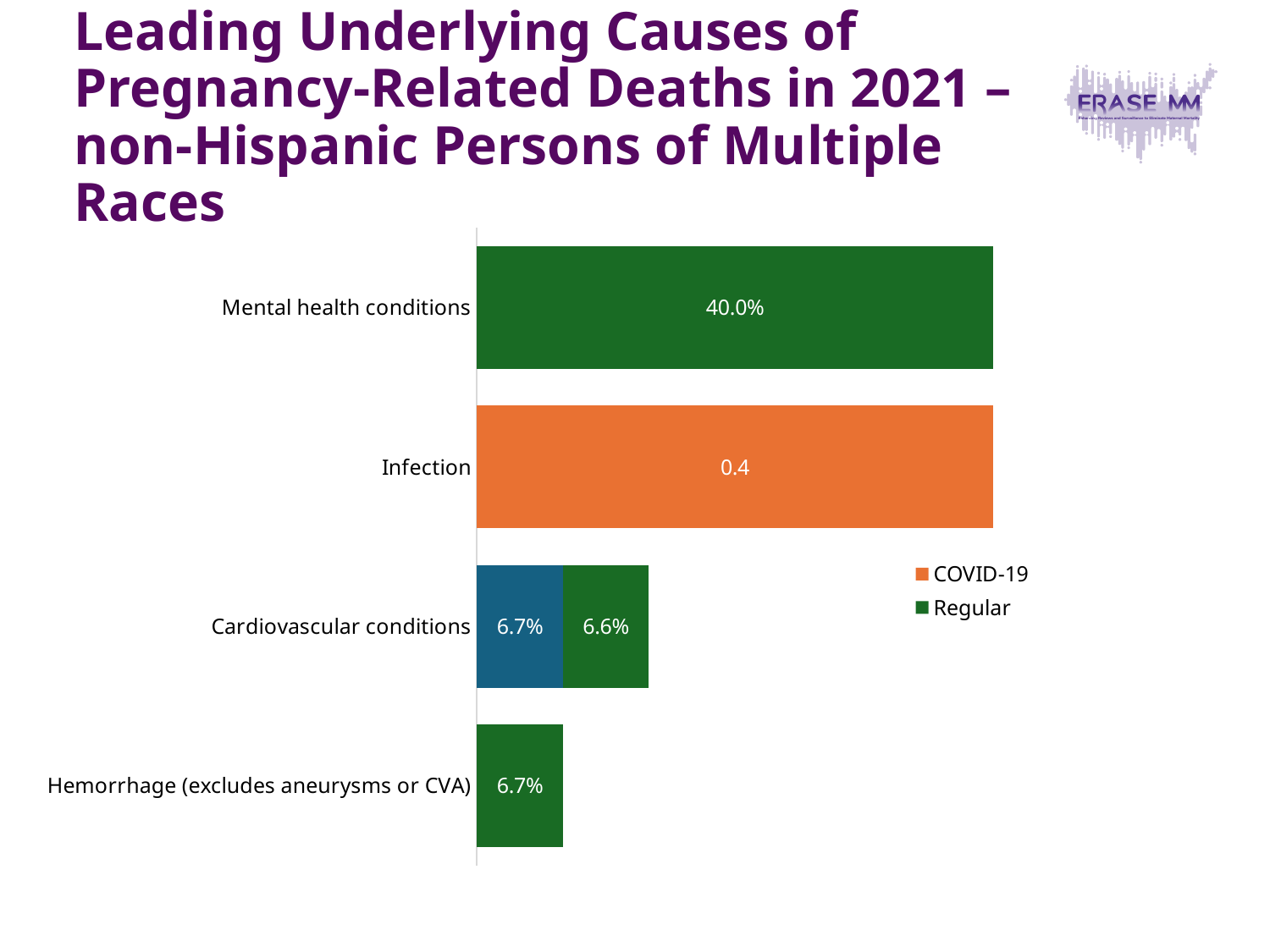
What is the difference between the value for Mental health conditions and the value for Hemorrhage (excludes aneurysms or CVA)? 33.3% How many categories are plotted on the chart? 4 Which category has the shortest bar on the chart? Hemorrhage (excludes aneurysms or CVA) What is the total of the stacked bar for Cardiovascular conditions? 13.3% What kind of chart is shown on the slide? bar chart What is the value of the green (Regular) segment for Cardiovascular conditions? 6.6% What value is shown for Hemorrhage (excludes aneurysms or CVA)? 6.7% What are the two entries listed in the legend? COVID-19 and Regular How many series does the legend list? 2 What value is shown for Mental health conditions? 40.0% What data label is shown on the Infection bar? 0.4 Which is larger, the value for Mental health conditions or the value for Hemorrhage (excludes aneurysms or CVA)? Mental health conditions